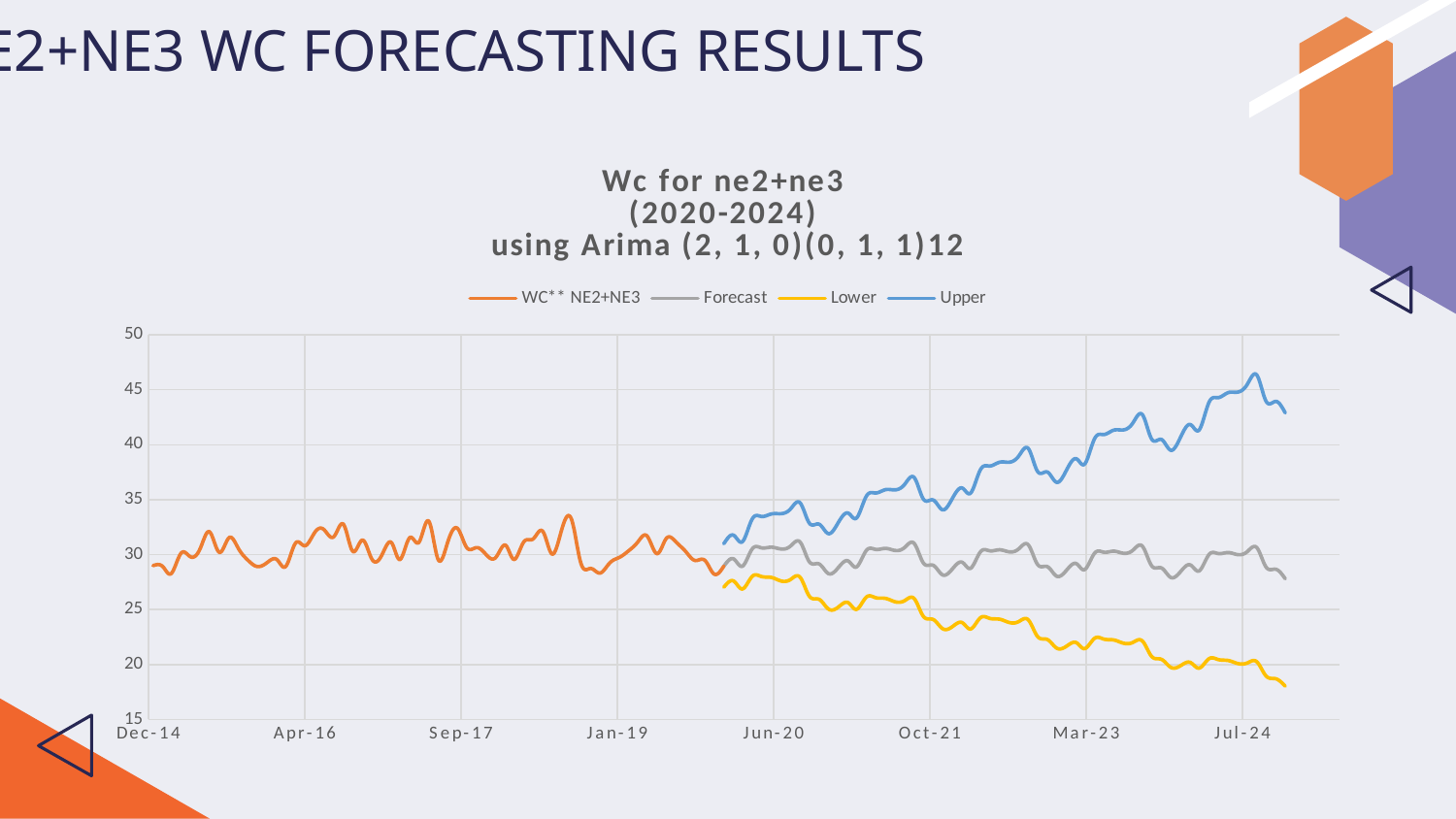
Which series reaches the highest value on the chart? Upper Does the Upper series rise or fall from Jun-20 to Jul-24? rise What are the four series named in the legend? WC** NE2+NE3, Forecast, Lower, Upper At Mar-23, which is larger, the Upper series or the Lower series? Upper How many date labels are shown on the x axis? 8 What kind of chart is shown on the slide? line chart Does the Lower series rise or fall from Jun-20 to Jul-24? fall Which series reaches the lowest value on the chart? Lower Is the value of the Lower series at Jul-24 greater or less than 25? less How many series does the legend list? 4 Is the value of the Upper series at Jul-24 greater or less than 40? greater What colour is the Upper series line? blue